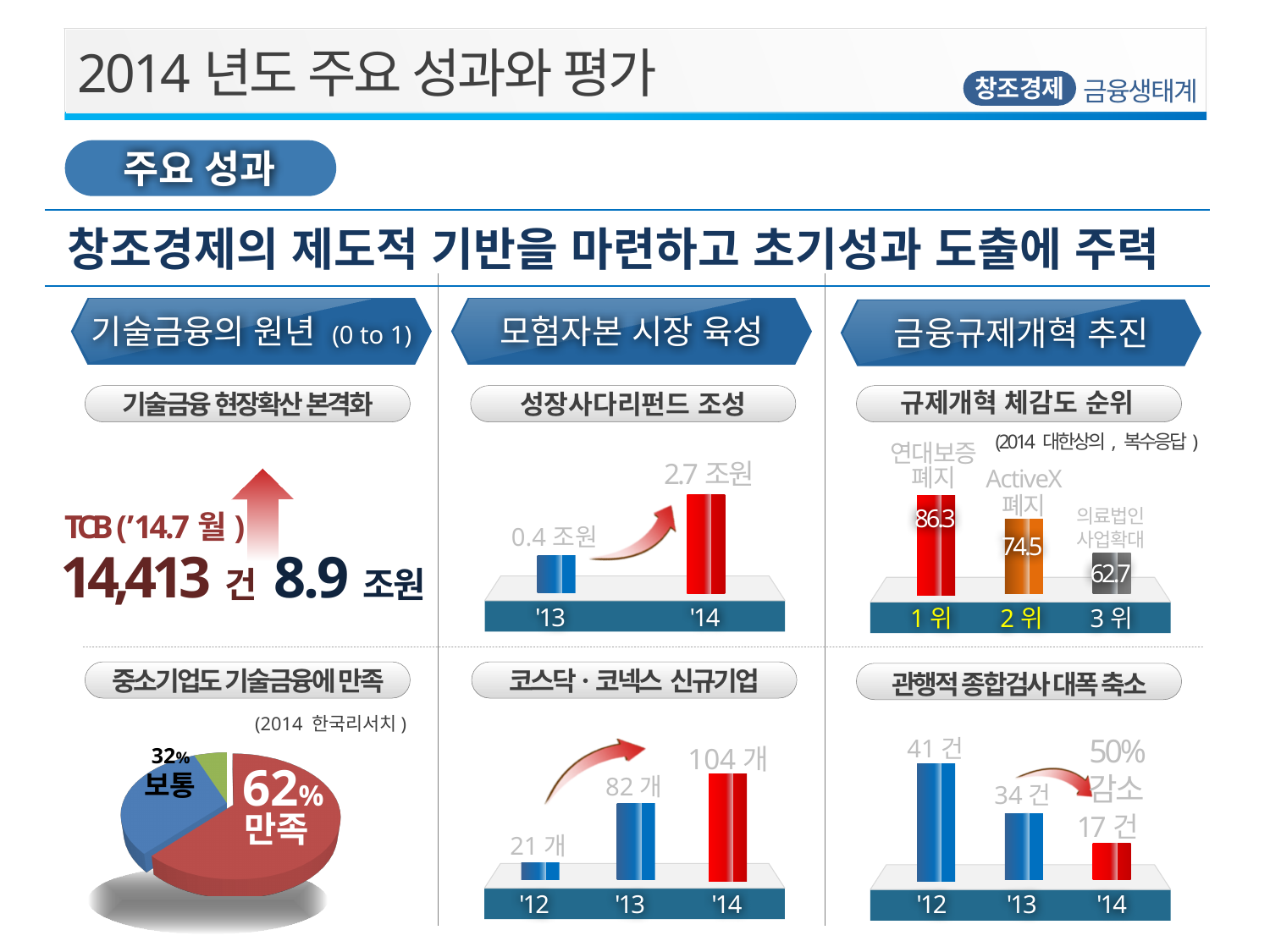
In the '관행적 종합검사 대폭 축소' chart, what is the value for '12? 41 건 In the '규제개혁 체감도 순위' chart, what is the difference between 연대보증 폐지 and ActiveX 폐지? 11.8 What kind of chart is used for '중소기업도 기술금융에 만족'? pie chart In the '코스닥·코넥스 신규기업' chart, do the values rise or fall from '12 to '14? rise In the '성장사다리펀드 조성' chart, what is the value for '13? 0.4 조원 In the '규제개혁 체감도 순위' chart, which category has the lowest value? 의료법인 사업확대 In the '규제개혁 체감도 순위' chart, what is the value for 연대보증 폐지? 86.3 In the '코스닥·코넥스 신규기업' chart, how many years are shown? 3 In the '성장사다리펀드 조성' chart, what is the value for '14? 2.7 조원 In the '코스닥·코넥스 신규기업' chart, what is the value for '13? 82 개 In the '관행적 종합검사 대폭 축소' chart, what is the difference between '13 and '14? 17 건 In the '중소기업도 기술금융에 만족' chart, what share is labelled 만족? 62%